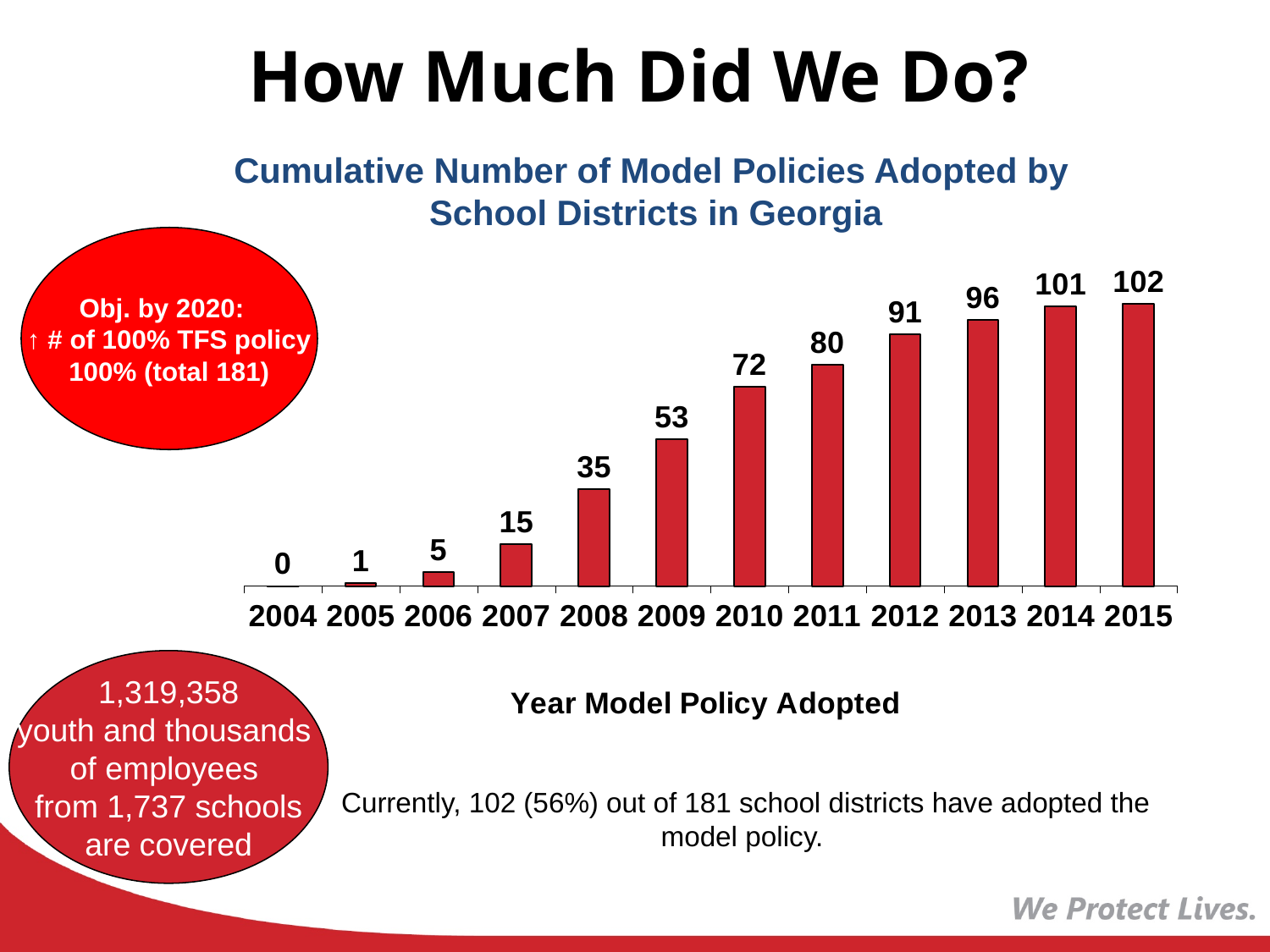
What kind of chart is shown on the slide? Bar chart Do the values rise or fall from 2004 to 2015? Rise Which year has the highest value on the chart? 2015 What is the title of the chart? Cumulative Number of Model Policies Adopted by School Districts in Georgia What value is shown for 2007? 15 What is the x-axis label of the chart? Year Model Policy Adopted What is the cumulative number of model policies adopted in 2010? 72 Which year has the lowest value on the chart? 2004 How many years are shown on the x axis? 12 What is the difference between the values for 2012 and 2009? 38 Which year has the larger value, 2008 or 2011? 2011 What value is shown for 2013? 96